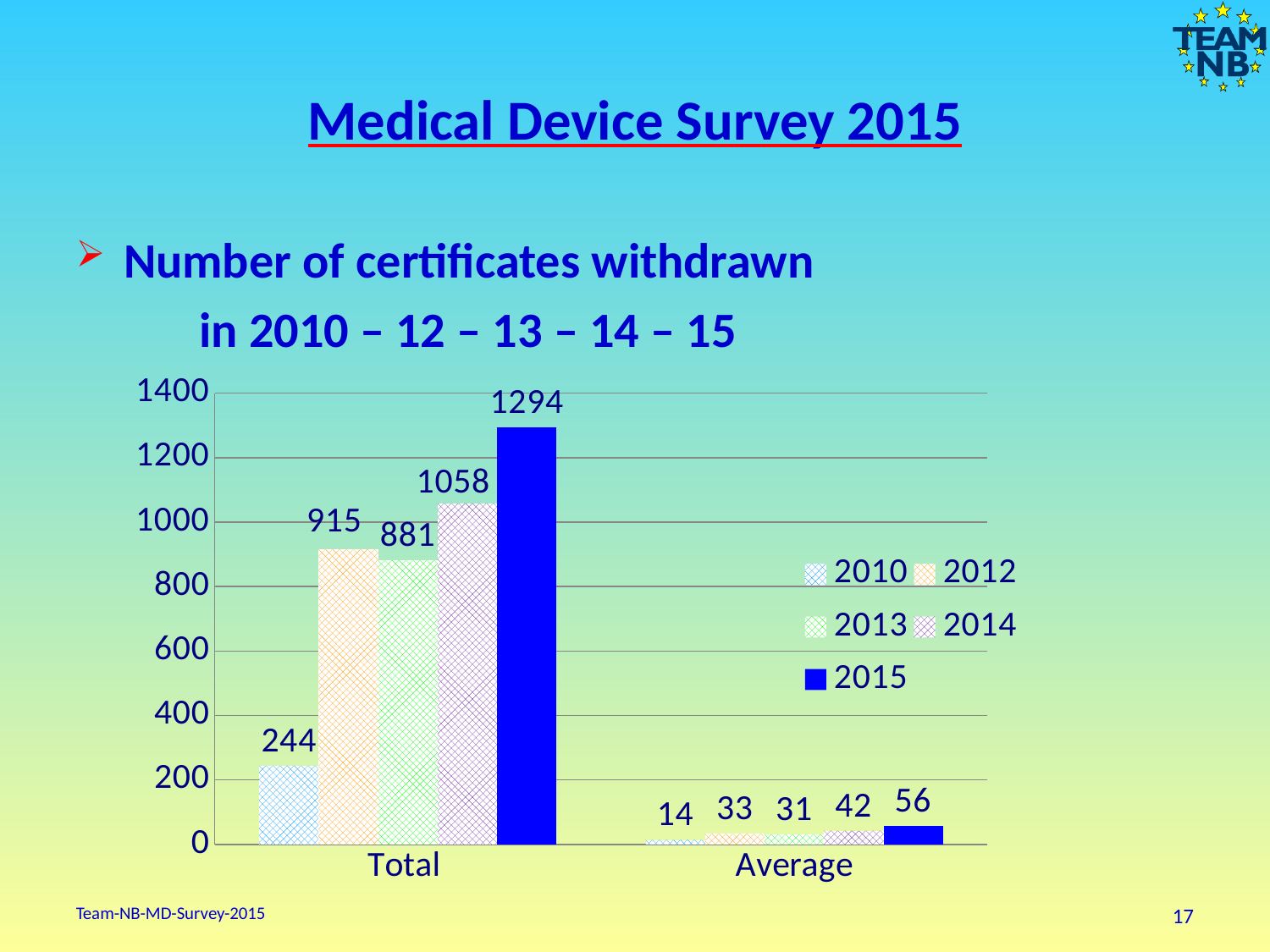
What kind of chart is shown on the slide? bar chart Which year has the lowest Average value? 2010 How many categories are shown on the x axis? 2 Which year has the highest Total number of certificates withdrawn? 2015 What is the Average value for 2010? 14 What is the Total number of certificates withdrawn in 2015? 1294 How many series does the legend list? 5 Which is larger, the Total value for 2012 or for 2013? 2012 What is the difference between the Total values for 2015 and 2014? 236 Is the Total value for 2010 greater or less than 400? less What is the Total value for 2013? 881 What is the difference between the Average values for 2015 and 2014? 14